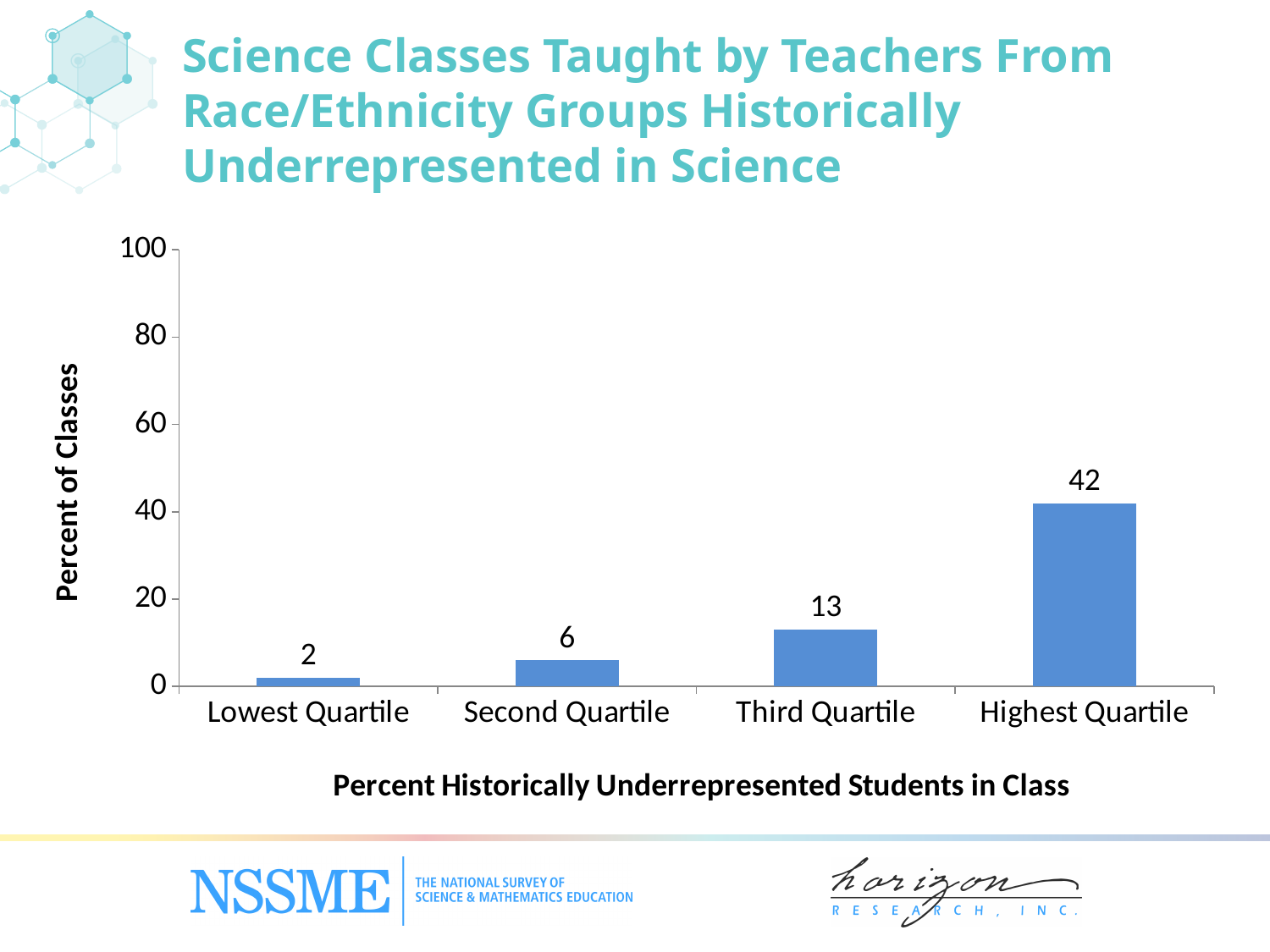
Which is larger, the value for Second Quartile or the value for Third Quartile? Third Quartile How many categories are shown on the x axis? 4 Which category has the lowest value? Lowest Quartile What is the value for Second Quartile? 6 What kind of chart is shown on the slide? bar chart Is the value for Highest Quartile greater or less than 40? greater Do the values rise or fall from Lowest Quartile to Highest Quartile? rise Which category has the highest value? Highest Quartile What is the value for Third Quartile? 13 What is the value for Highest Quartile? 42 What is the difference between the values for Highest Quartile and Third Quartile? 29 What is the value for Lowest Quartile? 2